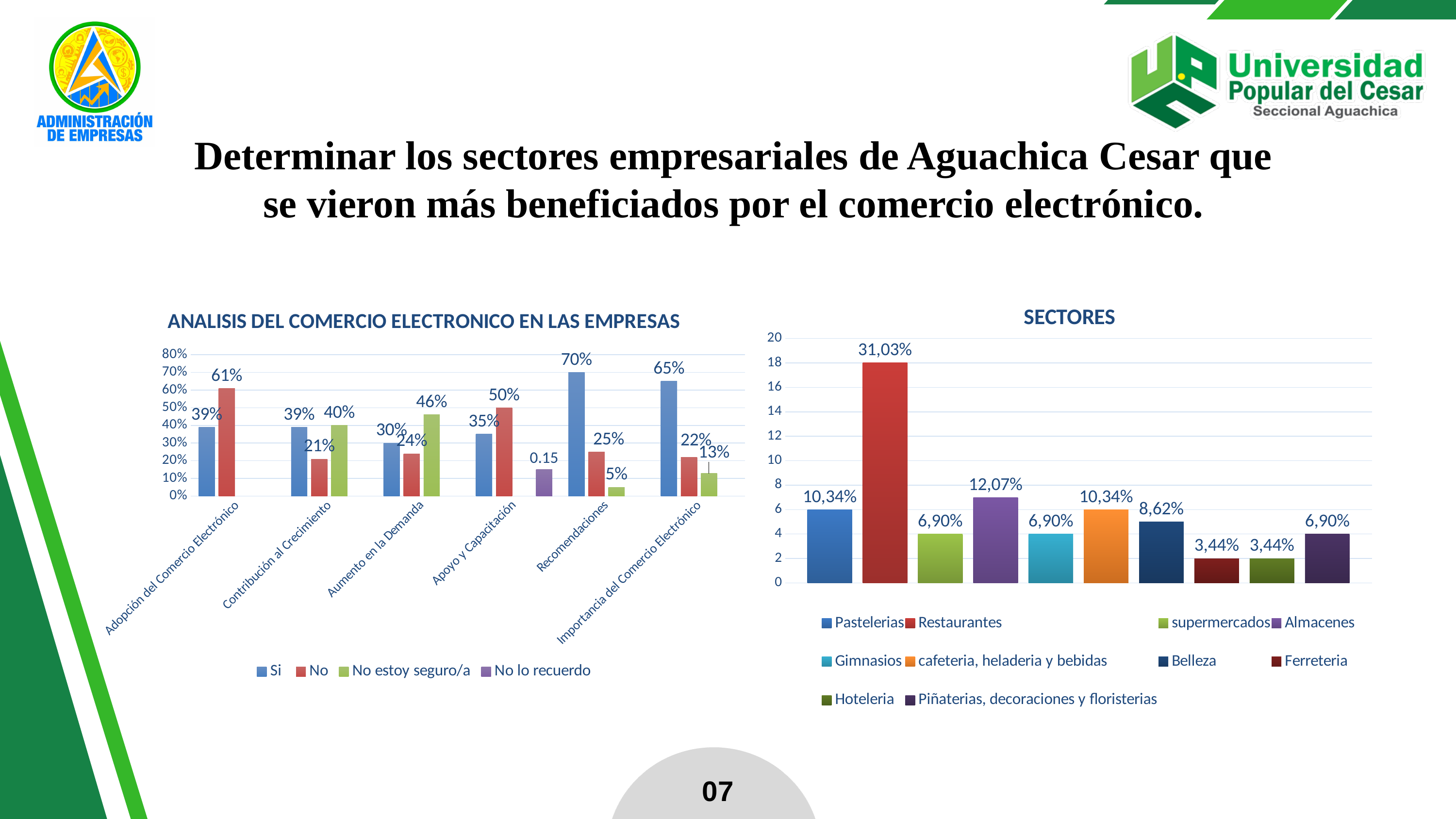
In the chart titled 'ANALISIS DEL COMERCIO ELECTRONICO EN LAS EMPRESAS', how many categories are shown on the x axis? 6 In the chart titled 'SECTORES', which is larger, the value for 'Belleza' or the value for 'Ferreteria'? Belleza In the chart titled 'ANALISIS DEL COMERCIO ELECTRONICO EN LAS EMPRESAS', what is the 'Si' value for 'Recomendaciones'? 70% In the chart titled 'SECTORES', what is the data label for 'Restaurantes'? 31,03% In the chart titled 'SECTORES', what is the data label for 'Almacenes'? 12,07% In the chart titled 'ANALISIS DEL COMERCIO ELECTRONICO EN LAS EMPRESAS', what is the 'No estoy seguro/a' value for 'Aumento en la Demanda'? 46% In the chart titled 'ANALISIS DEL COMERCIO ELECTRONICO EN LAS EMPRESAS', which category has the highest 'Si' value? Recomendaciones In the chart titled 'SECTORES', which sector has the highest value? Restaurantes In the chart titled 'ANALISIS DEL COMERCIO ELECTRONICO EN LAS EMPRESAS', how many series does the legend list? 4 What kind of chart is the chart titled 'SECTORES'? Bar chart In the chart titled 'ANALISIS DEL COMERCIO ELECTRONICO EN LAS EMPRESAS', what is the 'No' value for 'Adopción del Comercio Electrónico'? 61% In the chart titled 'ANALISIS DEL COMERCIO ELECTRONICO EN LAS EMPRESAS', what is the difference between the 'No' and 'Si' values for 'Apoyo y Capacitación'? 15%